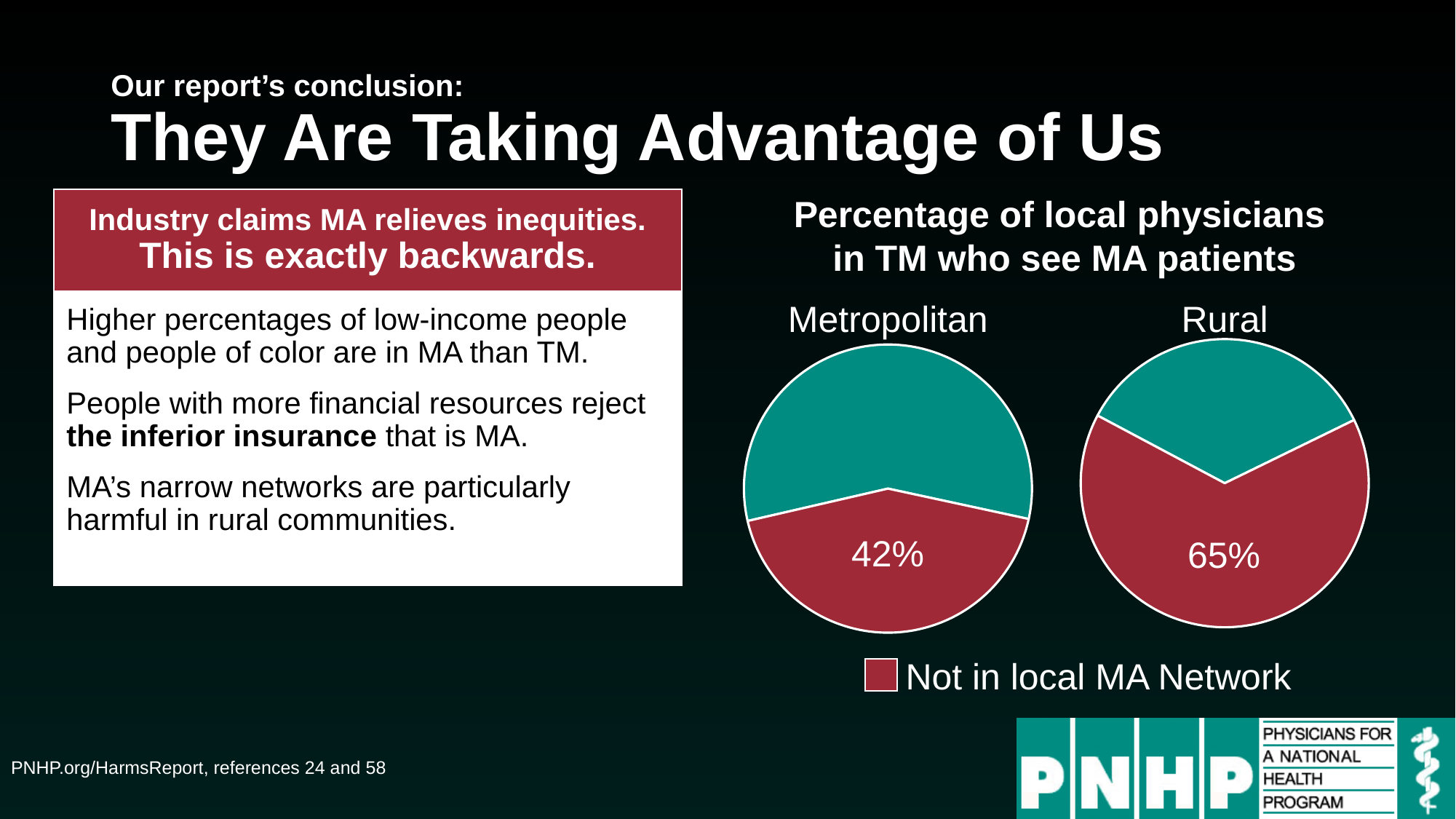
How many entries does the legend below the pie charts list? 1 How many pie charts are shown on the slide? 2 In the Rural pie chart, is the 'Not in local MA Network' share greater or less than 50%? greater What is the title above the two pie charts? Percentage of local physicians in TM who see MA patients What colour represents 'Not in local MA Network' in the pie charts? Red In the Metropolitan pie chart, is the 'Not in local MA Network' share greater or less than 50%? less What is the difference between the Rural and Metropolitan 'Not in local MA Network' percentages? 23 percentage points In the Rural pie chart, what percentage of local physicians in TM are not in the local MA network? 65% What kind of chart is used to show the percentage of local physicians in TM who see MA patients? Pie chart How many slices does the Metropolitan pie chart have? 2 Comparing the Metropolitan and Rural pie charts, which has the larger 'Not in local MA Network' share? Rural In the Metropolitan pie chart, what percentage of local physicians in TM are not in the local MA network? 42%